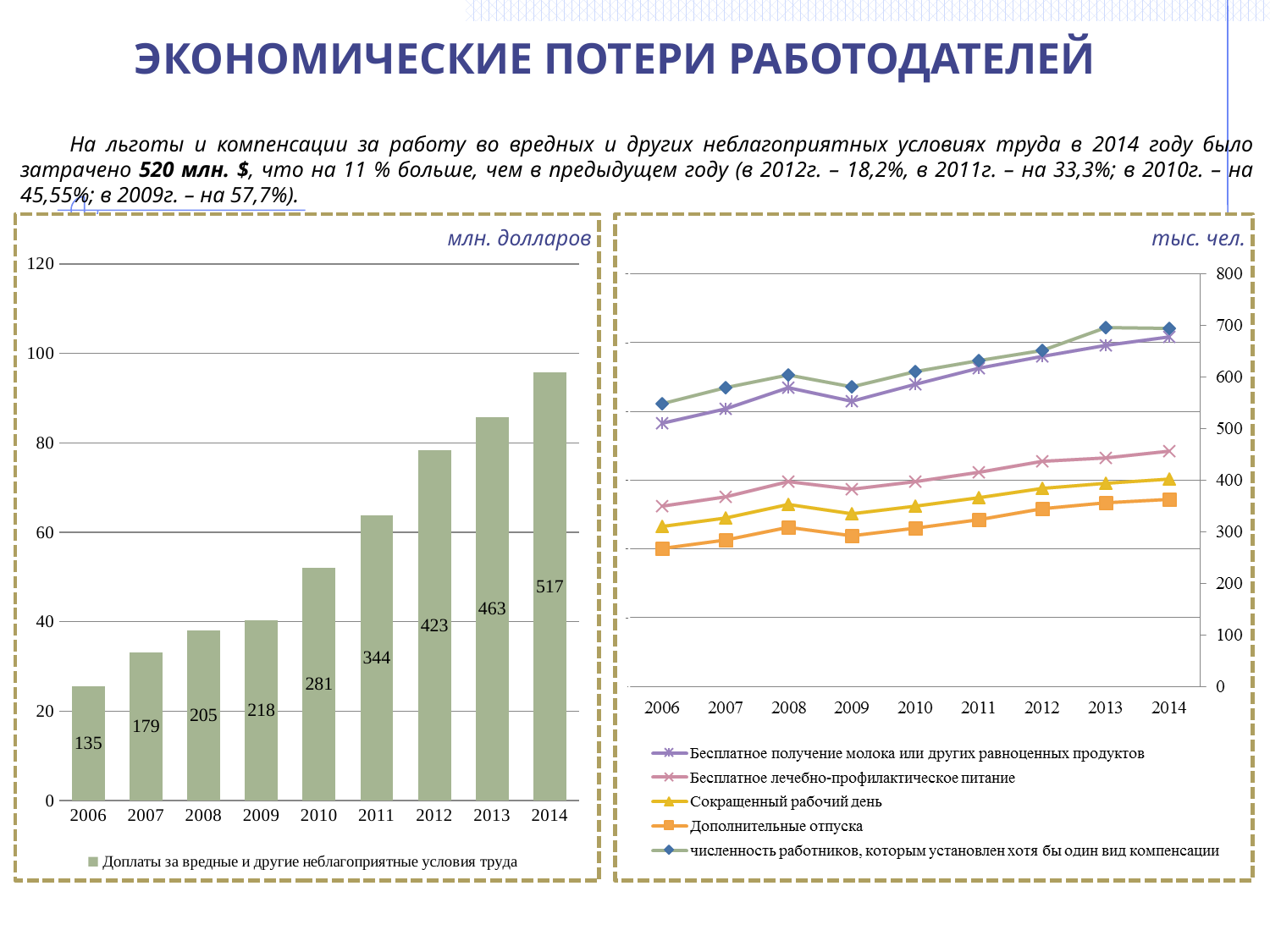
On the left chart, what is the difference between the labelled values for 2014 and 2013? 54 On the left chart, do the values rise or fall from 2006 to 2014? rise On the left chart, what is the data label for 2014? 517 On the left chart, what is the data label for 2010? 281 On the left chart, which year has the highest value? 2014 On the left chart, what is the data label for 2006? 135 How many series does the legend of the right chart list? 5 On the right chart, is the value for 'Дополнительные отпуска' in 2006 greater or less than 300? less On the right chart, is the value for 'Бесплатное лечебно-профилактическое питание' in 2014 greater or less than 400? greater On the left chart, which year has the lowest value? 2006 What kind of chart is the left chart? bar chart On the left chart, how many years are shown on the x axis? 9